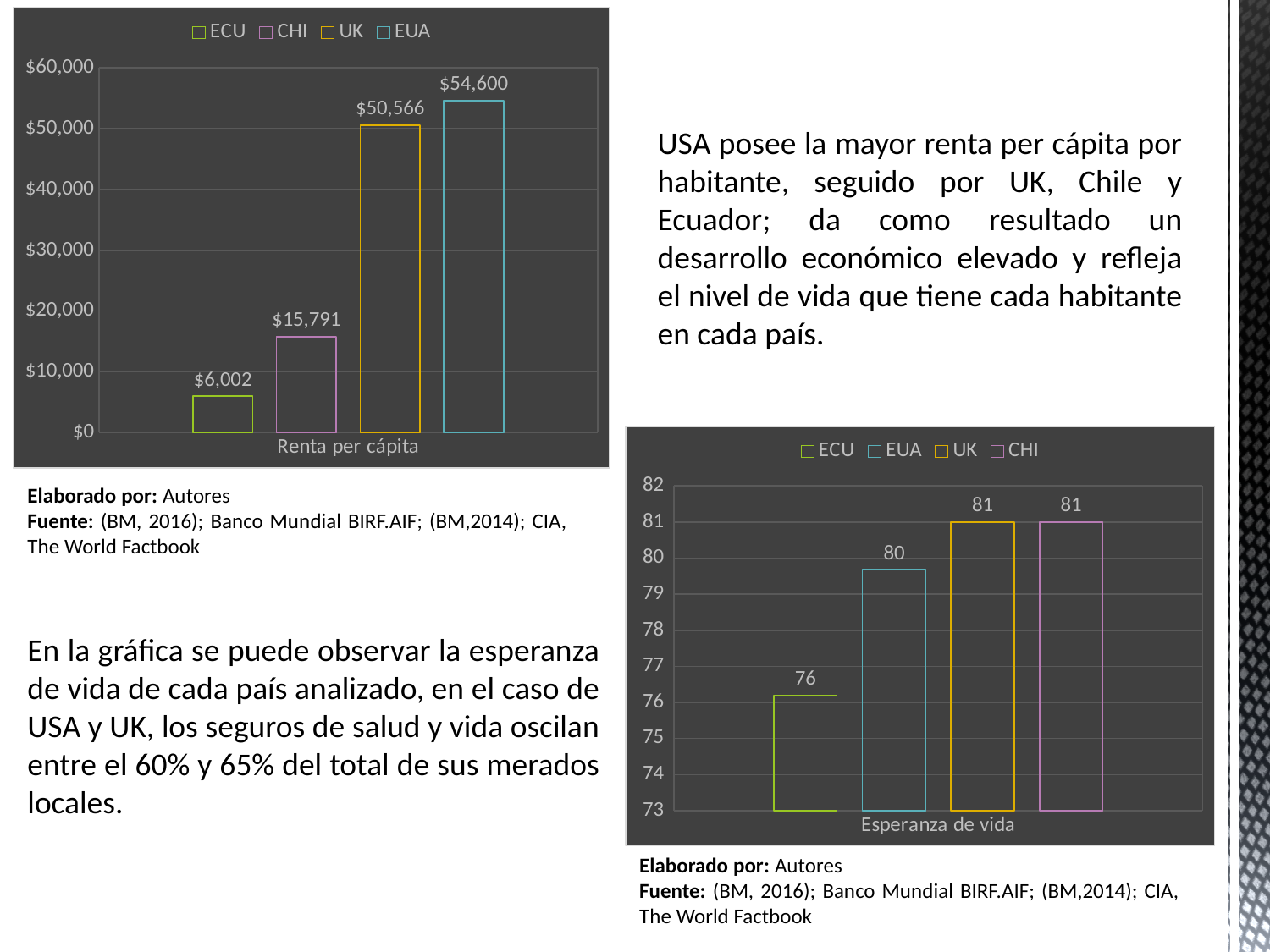
In the Esperanza de vida chart (bottom right), what is the value for ECU? 76 In the Esperanza de vida chart (bottom right), which series has the lowest value? ECU What kind of chart is the Esperanza de vida chart (bottom right)? bar chart In the Renta per cápita chart (top left), which series has the lowest value? ECU In the Renta per cápita chart (top left), what is the value for ECU? $6,002 In the Renta per cápita chart (top left), what is the difference between the EUA value and the UK value? $4,034 In the Esperanza de vida chart (bottom right), which is larger, the value for UK or the value for ECU? UK In the Renta per cápita chart (top left), which series has the highest value? EUA In the Renta per cápita chart (top left), what is the value for UK? $50,566 In the Esperanza de vida chart (bottom right), what is the difference between the UK value and the ECU value? 5 In the Renta per cápita chart (top left), how many series does the legend list? 4 In the Renta per cápita chart (top left), is the value for CHI greater or less than $20,000? less